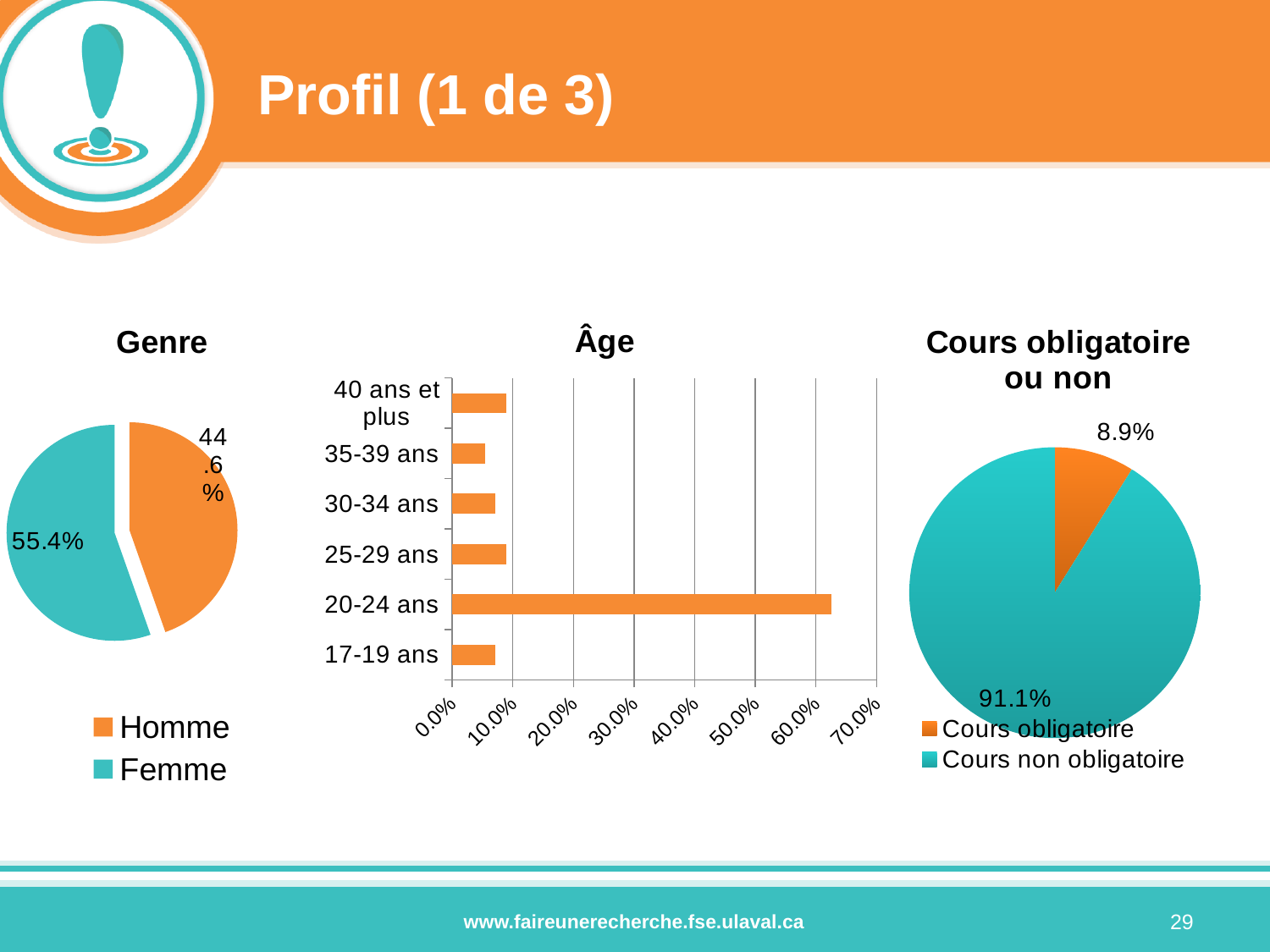
In the 'Cours obligatoire ou non' chart, what percentage is shown for Cours non obligatoire? 91.1% In the 'Âge' chart, is the value for 35-39 ans greater or less than 10.0%? less What kind of chart is the 'Âge' chart? Bar chart What kind of chart is the 'Genre' chart? Pie chart In the 'Genre' chart, what percentage is shown for Homme? 44.6% In the 'Âge' chart, is the value for 20-24 ans greater or less than 50.0%? greater In the 'Genre' chart, what percentage is shown for Femme? 55.4% In the 'Genre' chart, what is the difference between the Femme and Homme percentages? 10.8% In the 'Cours obligatoire ou non' chart, what percentage is shown for Cours obligatoire? 8.9% In the 'Âge' chart, which age group has the highest value? 20-24 ans In the 'Âge' chart, how many age groups are shown? 6 In the 'Genre' chart, which category has the larger share, Homme or Femme? Femme